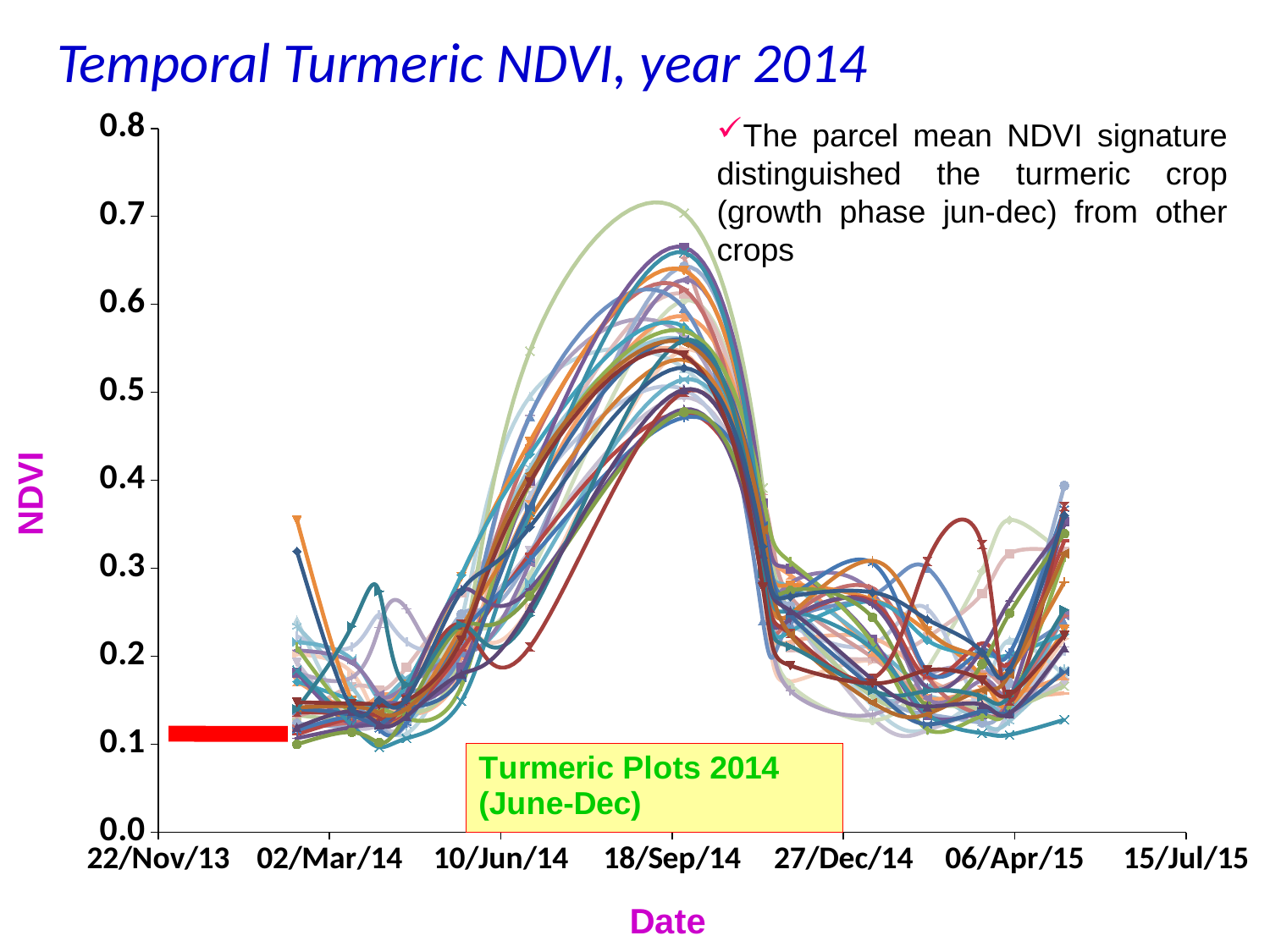
How many date tick labels are shown on the x axis? 7 Do the NDVI values rise or fall between 18/Sep/14 and 27/Dec/14? fall Is the peak NDVI value of the highest curve greater or less than 0.6? greater What is the label of the y axis? NDVI What is the highest tick value shown on the y axis? 0.8 What kind of chart is shown on the slide? line chart Is the lowest NDVI value plotted on the chart greater or less than 0.2? less Are the NDVI values around 02/Mar/14 greater or less than 0.4? less What is the first date label shown on the x axis? 22/Nov/13 What is the title of the chart on the slide? Temporal Turmeric NDVI, year 2014 Do the NDVI values rise or fall between 10/Jun/14 and 18/Sep/14? rise Around which x-axis date do the NDVI curves reach their peak? 18/Sep/14